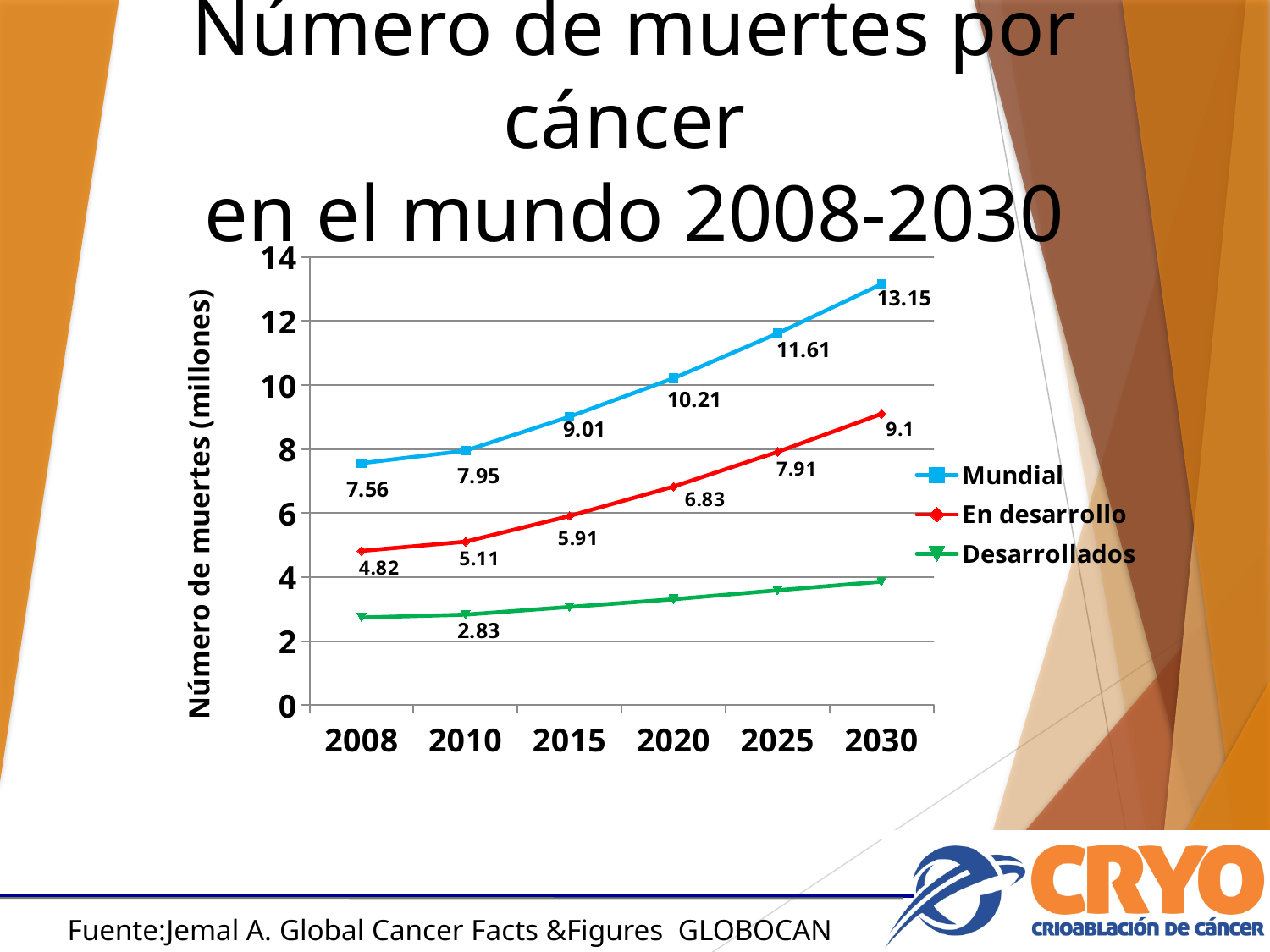
What is the value for Mundial in 2030? 13.15 How many years are shown on the x axis? 6 What is the value for Desarrollados in 2010? 2.83 What kind of chart is shown on the slide? line chart How many series does the legend list? 3 What is the value for En desarrollo in 2020? 6.83 In which year is the Mundial series at its highest? 2030 In which year is the En desarrollo series at its lowest? 2008 Which is larger in 2025: the Mundial value or the En desarrollo value? Mundial Is the value for Desarrollados in 2030 greater or less than 4? less What is the difference between the Mundial values in 2030 and 2008? 5.59 Does the En desarrollo series rise or fall from 2008 to 2030? rise